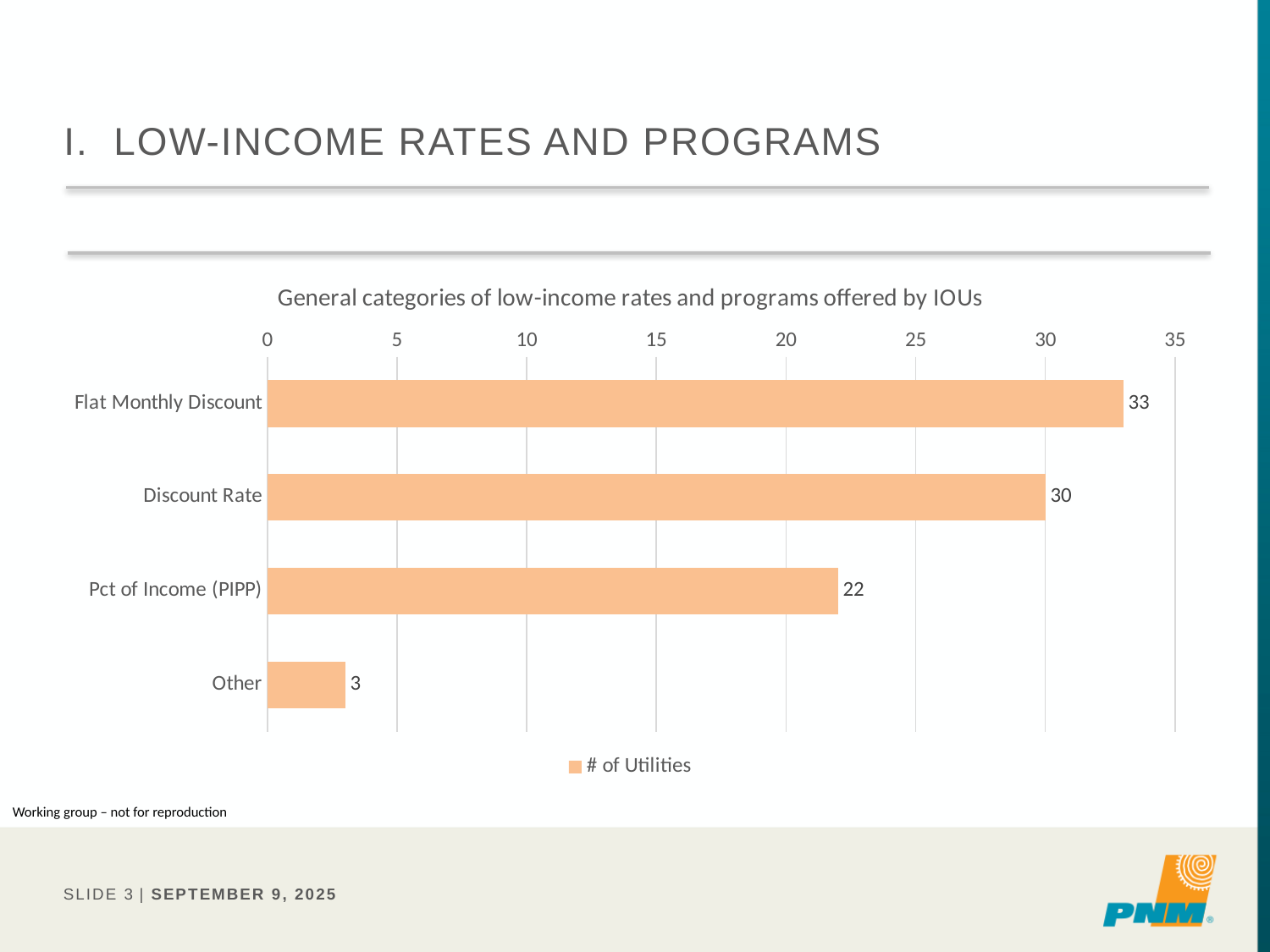
Which is larger, the value for Pct of Income (PIPP) or the value for Other? Pct of Income (PIPP) How many categories are shown in the chart? 4 What is the difference between the values for Flat Monthly Discount and Discount Rate? 3 What is the value for Pct of Income (PIPP)? 22 Which category has the lowest number of utilities? Other What kind of chart is shown on the slide? Bar chart What is the value for Other? 3 What is the difference between the values for Discount Rate and Pct of Income (PIPP)? 8 Which category has the highest number of utilities? Flat Monthly Discount What is the title of the chart? General categories of low-income rates and programs offered by IOUs What is the value for Discount Rate? 30 What is the value for Flat Monthly Discount? 33